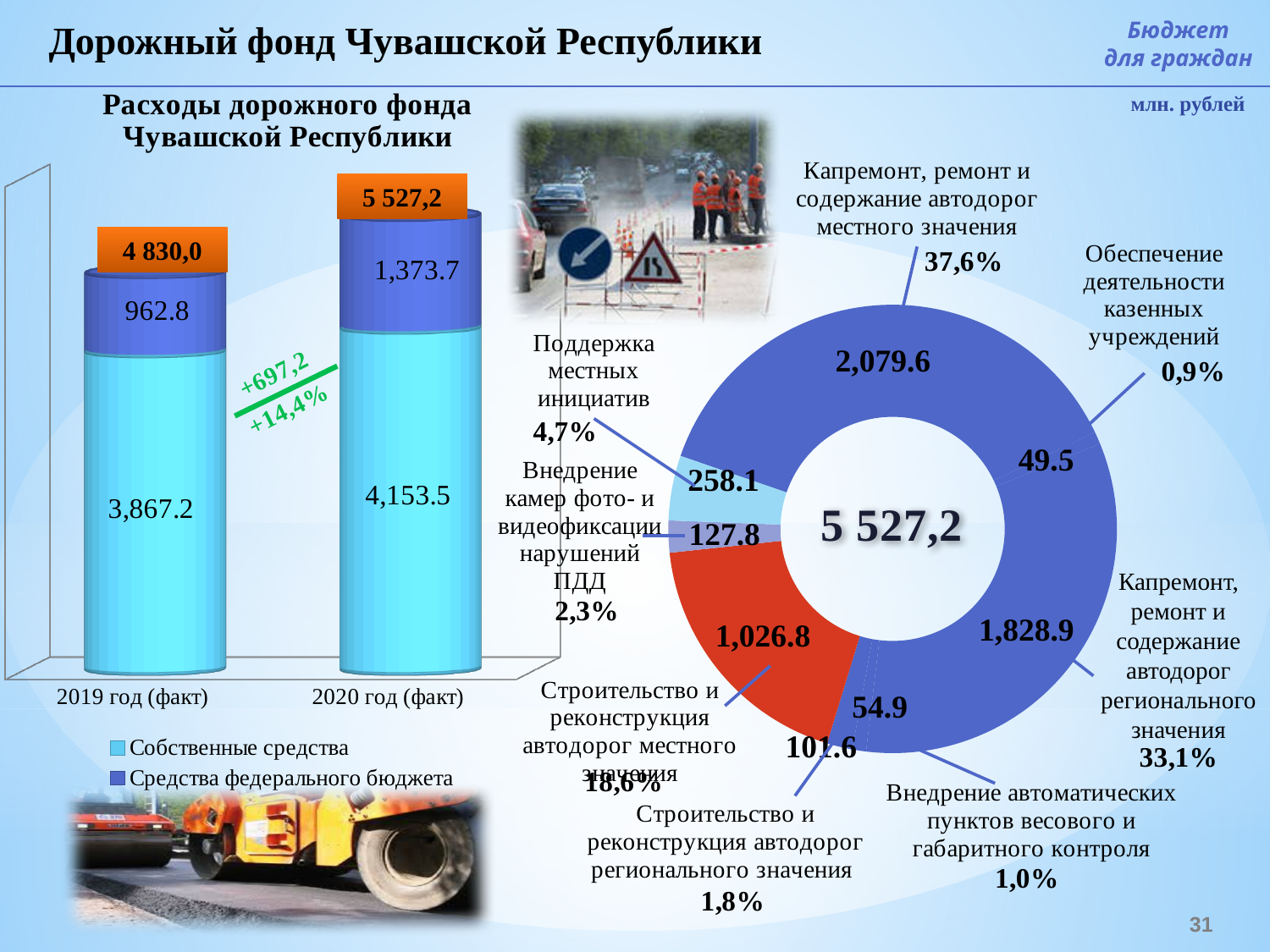
In the bar chart 'Расходы дорожного фонда Чувашской Республики', what is the difference between 'Собственные средства' in 2020 and in 2019? 286.3 What kind of chart is the chart on the right side of the slide with the total 5 527,2 in the centre? doughnut chart In the bar chart 'Расходы дорожного фонда Чувашской Республики', what is the total for '2020 год (факт)'? 5 527,2 In the bar chart 'Расходы дорожного фонда Чувашской Республики', what is the value of 'Средства федерального бюджета' for '2019 год (факт)'? 962.8 In the doughnut chart on the right, what share does 'Капремонт, ремонт и содержание автодорог регионального значения' have? 33,1% In the bar chart 'Расходы дорожного фонда Чувашской Республики', what is the total for '2019 год (факт)'? 4 830,0 In the bar chart 'Расходы дорожного фонда Чувашской Республики', which year has the larger value of 'Средства федерального бюджета'? 2020 год (факт) In the doughnut chart on the right, what is the value for 'Строительство и реконструкция автодорог местного значения'? 1,026.8 In the doughnut chart on the right, which category has the largest value? Капремонт, ремонт и содержание автодорог местного значения In the bar chart 'Расходы дорожного фонда Чувашской Республики', what is the value of 'Собственные средства' for '2020 год (факт)'? 4,153.5 In the bar chart 'Расходы дорожного фонда Чувашской Республики', how many series does the legend list? 2 In the doughnut chart on the right, which category has the smallest value? Обеспечение деятельности казенных учреждений